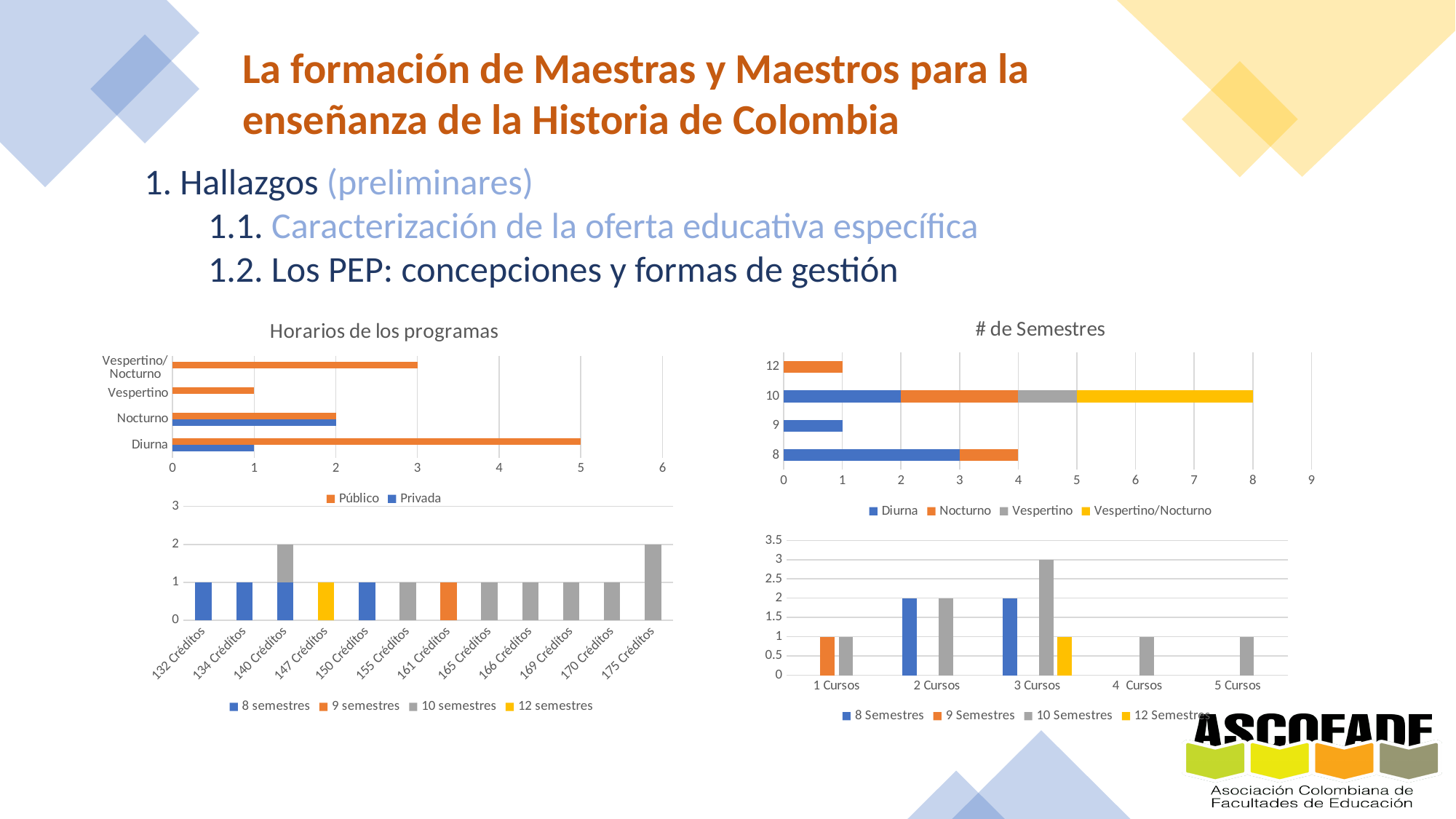
In the bottom-right chart with 'Cursos' categories, what is the value for 10 Semestres at 3 Cursos? 3 In the bottom-left chart with credit categories, how many categories are shown on the x axis? 12 In the bottom-left chart with credit categories, what is the value for 10 semestres at 175 Créditos? 2 In the '# de Semestres' chart, which category has the longest stacked bar? 10 In the '# de Semestres' chart, what is the total of the stacked bar for 10 semesters? 8 In the bottom-right chart with 'Cursos' categories, what kind of chart is it? Bar chart In the 'Horarios de los programas' chart, what is the value for Privada in the Nocturno category? 2 In the 'Horarios de los programas' chart, how many series does the legend list? 2 In the 'Horarios de los programas' chart, which category has the highest Público value? Diurna In the '# de Semestres' chart, how many series does the legend list? 4 In the '# de Semestres' chart, what is the Diurna value for 8 semesters? 3 In the 'Horarios de los programas' chart, what is the value for Público in the Diurna category? 5